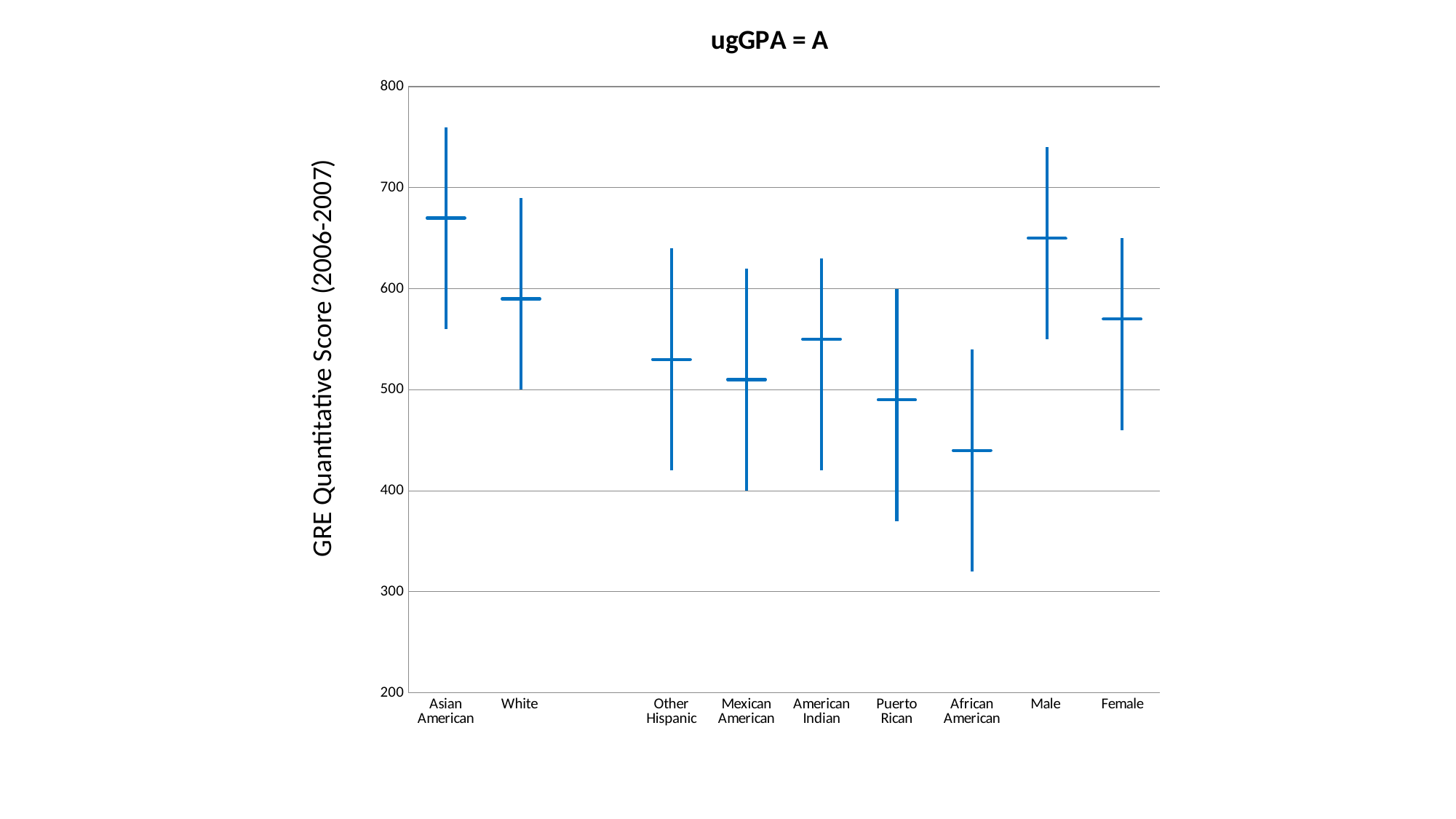
How many categories are shown along the x axis of the chart? 9 Is the central marker for Asian American greater or less than 600? greater Which category has the highest central (mean) GRE Quantitative Score marker? Asian American Which has the higher central GRE Quantitative Score marker, Male or Female? Male What is the title of the chart? ugGPA = A What is the lowest value reached by the vertical range line for Mexican American? 400 Is the central marker for African American greater or less than 500? less Which category has the lowest central (mean) GRE Quantitative Score marker? African American Which has the higher central GRE Quantitative Score marker, Asian American or White? Asian American What is the label on the vertical axis of the chart? GRE Quantitative Score (2006-2007) Is the central marker for Male greater or less than 600? greater